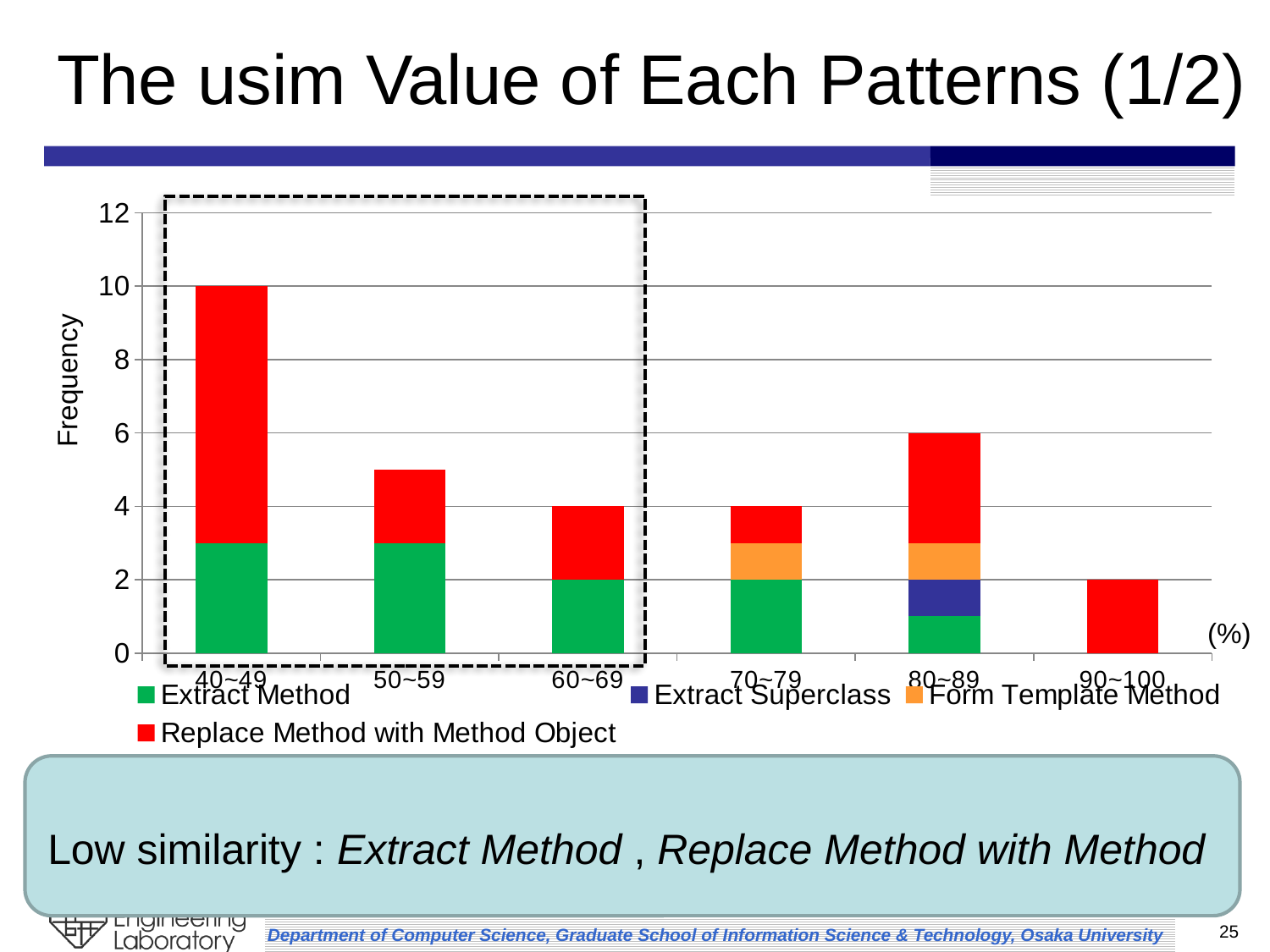
What is the total frequency of the stacked bar for 80~89? 6 Which usim range is the only one that includes the Extract Superclass series? 80~89 Which has a larger total frequency, 40~49 or 80~89? 40~49 Which usim range has the highest total frequency? 40~49 How many series does the legend list? 4 What kind of chart is shown on the slide? bar chart What is the difference between the total frequency for 40~49 and for 80~89? 4 Is the total frequency for 50~59 greater or less than 4? greater How many usim value ranges (categories) are shown on the x axis? 6 What is the total frequency of the stacked bar for 40~49? 10 Which usim range has the lowest total frequency? 90~100 What is the label of the y axis? Frequency